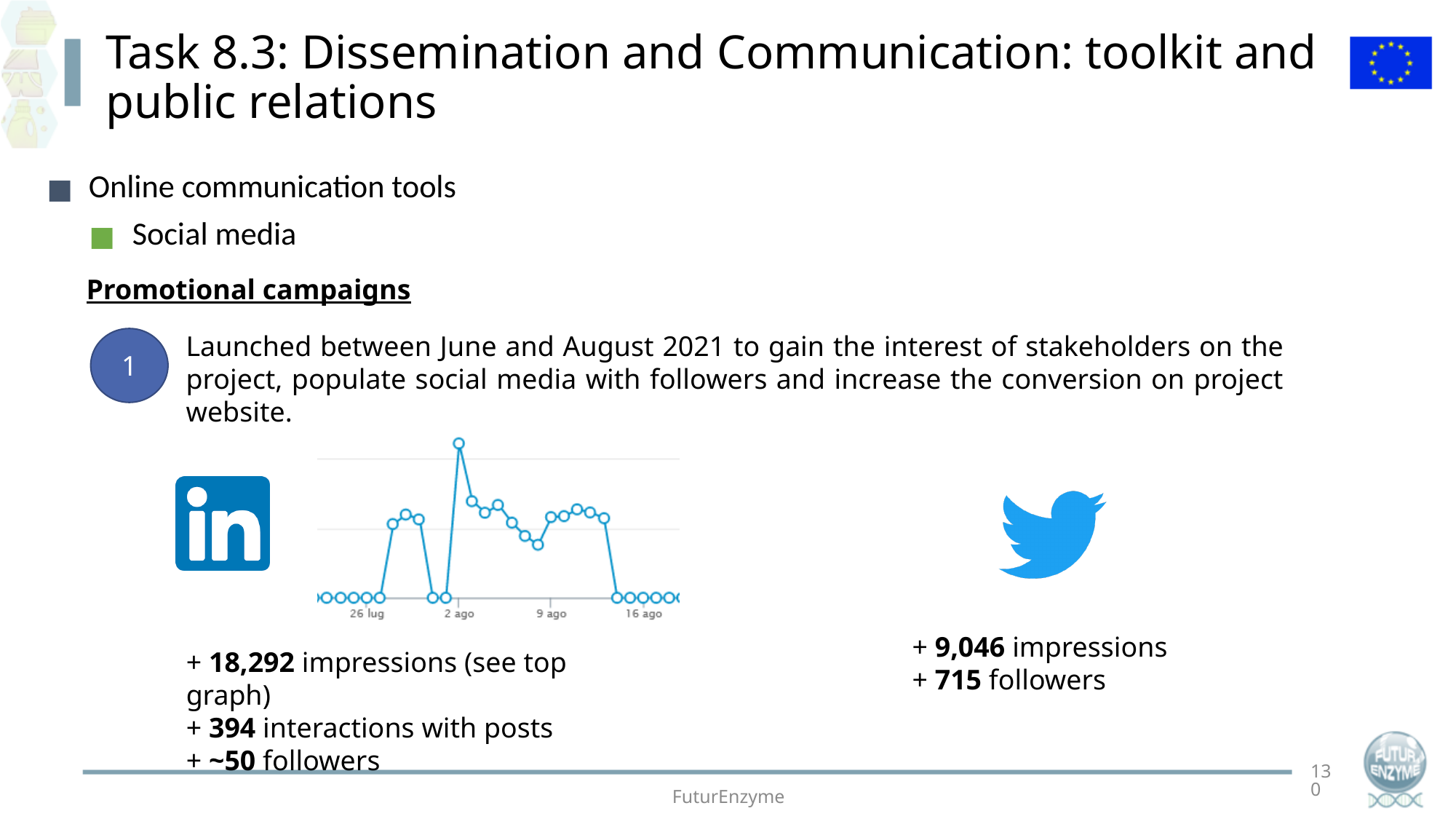
What kind of chart is shown next to the LinkedIn logo? line chart How many lines are plotted on the line chart? 1 What is the last x-axis label on the line chart? 16 ago What is the first x-axis label on the line chart? 26 lug Are the points before 26 lug at the bottom or near the top of the line chart? bottom Which x-axis label does the highest point of the line chart fall on? 2 ago How many x-axis tick labels are shown on the line chart? 4 Which social media platform does the line chart relate to? LinkedIn Do the values on the line chart rise or fall between 26 lug and 2 ago? rise Which is higher on the line chart, the value at 2 ago or the value at 9 ago? 2 ago Immediately after the peak at 2 ago, do the values on the line chart rise or fall? fall